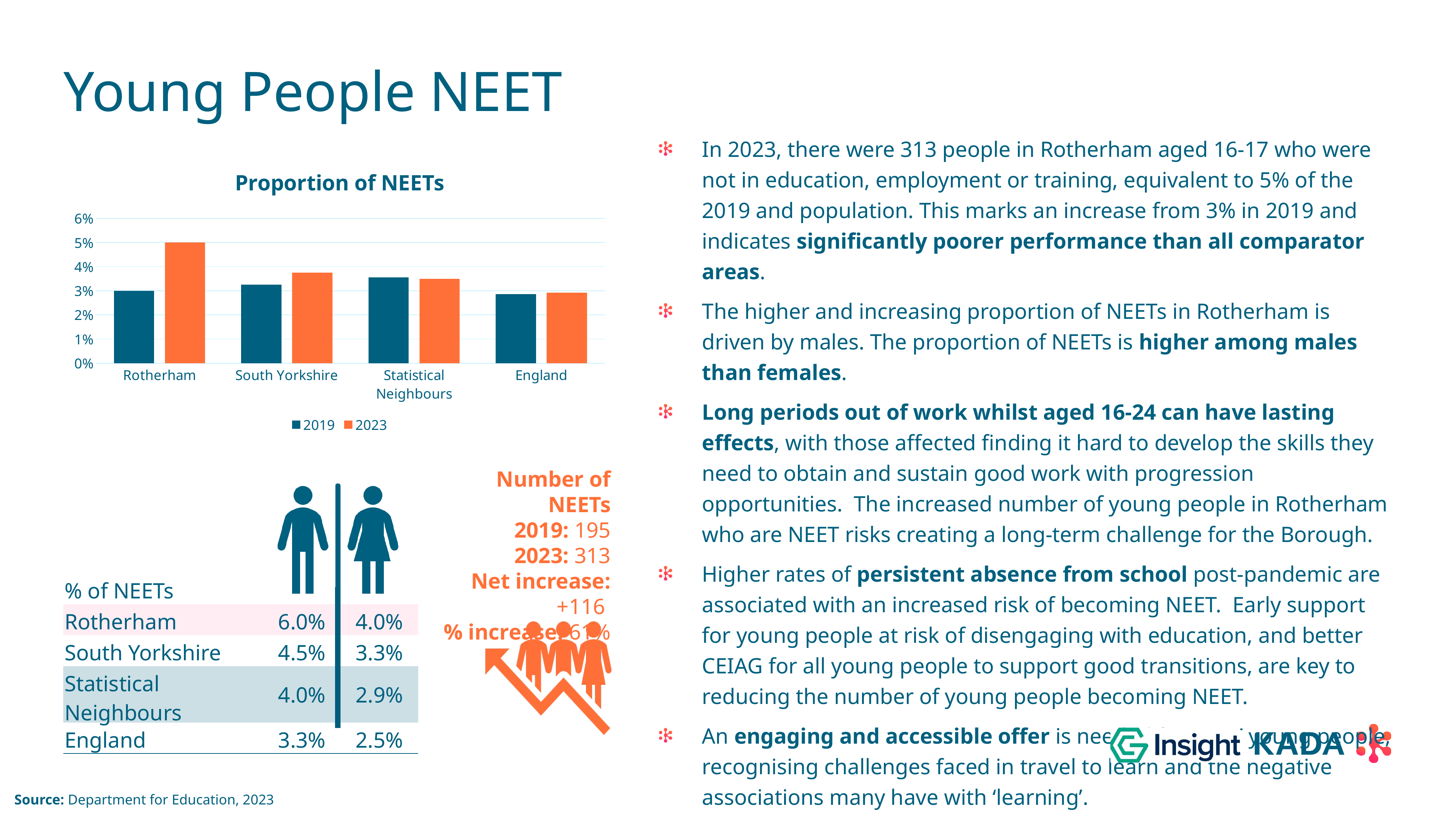
In the 'Proportion of NEETs' chart, what is the 2019 value for Rotherham? 3% How many categories are shown on the x axis of the 'Proportion of NEETs' chart? 4 In the 'Proportion of NEETs' chart, by how much did Rotherham's value increase from 2019 to 2023? 2% In the 'Proportion of NEETs' chart, is the 2023 value for South Yorkshire greater or less than 3%? greater In the 'Proportion of NEETs' chart, which is larger for Rotherham: the 2019 value or the 2023 value? 2023 How many series does the legend of the 'Proportion of NEETs' chart list? 2 What type of chart is the 'Proportion of NEETs' chart? bar chart In the 'Proportion of NEETs' chart, is the 2019 value for England greater or less than 4%? less In the 'Proportion of NEETs' chart, which category has the lowest 2023 value? England In the 'Proportion of NEETs' chart, what is the 2023 value for Rotherham? 5% In the 'Proportion of NEETs' chart, which colour represents the 2023 series? orange In the 'Proportion of NEETs' chart, which category has the highest 2023 value? Rotherham